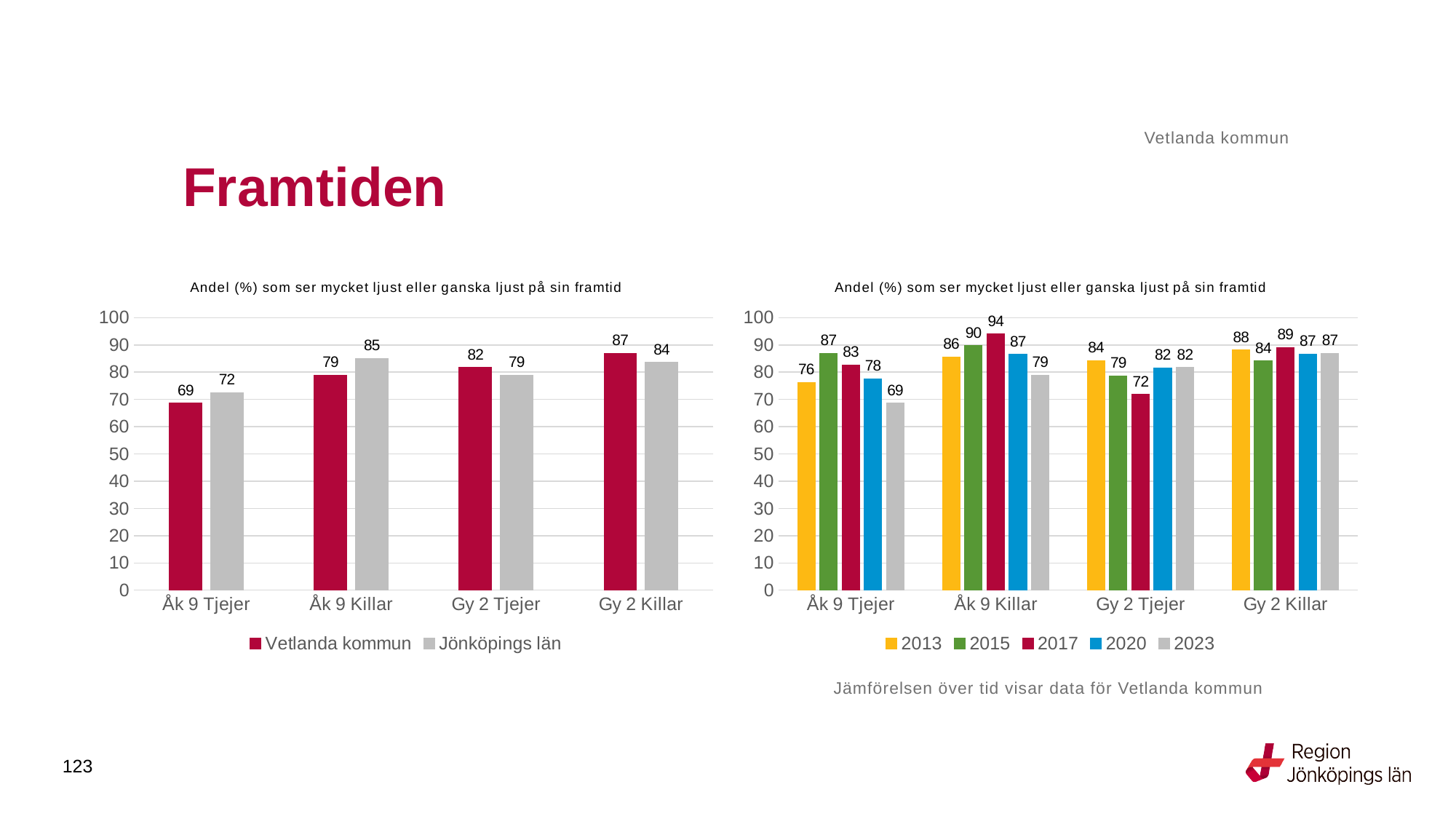
In the left chart, what is the difference between Vetlanda kommun and Jönköpings län for Gy 2 Tjejer? 3 In the right chart, what is the value for 2017 for Åk 9 Killar? 94 In the left chart, what is the value for Jönköpings län for Åk 9 Killar? 85 In the right chart, what is the difference between the 2013 and 2023 values for Åk 9 Tjejer? 7 In the left chart, what is the value for Vetlanda kommun for Åk 9 Tjejer? 69 In the right chart, what is the value for 2023 for Åk 9 Tjejer? 69 What kind of chart is the right chart? Bar chart In the left chart, which category has the highest value for Vetlanda kommun? Gy 2 Killar In the right chart, how many series does the legend list? 5 In the left chart, which is larger for Åk 9 Killar: Vetlanda kommun or Jönköpings län? Jönköpings län In the left chart, how many series does the legend list? 2 In the right chart, which year has the lowest value for Gy 2 Tjejer? 2017